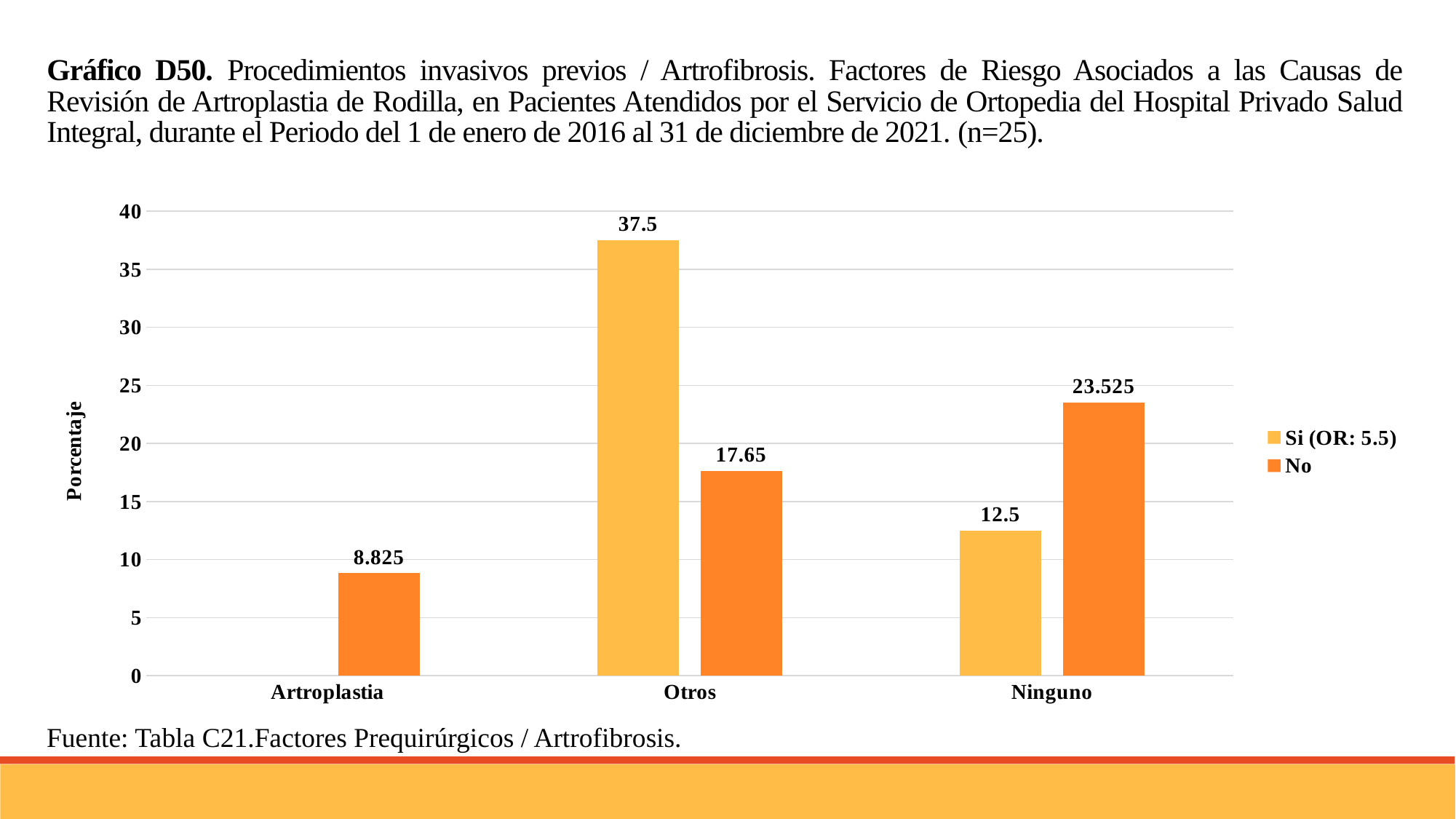
What is the value of the 'Si (OR: 5.5)' series for Otros? 37.5 What type of chart is shown on the slide? Bar chart For Ninguno, which series has the larger value, 'Si (OR: 5.5)' or 'No'? No What is the difference between the 'Si (OR: 5.5)' and 'No' values for Otros? 19.85 What is the value of the 'Si (OR: 5.5)' series for Ninguno? 12.5 How many categories are shown on the x axis? 3 What is the value of the 'No' series for Ninguno? 23.525 How many series does the legend list? 2 Which category has the highest value in the 'No' series? Ninguno Which category has the lowest value in the 'No' series? Artroplastia Is the 'No' value for Otros greater or less than 15? greater What is the value of the 'No' series for Artroplastia? 8.825